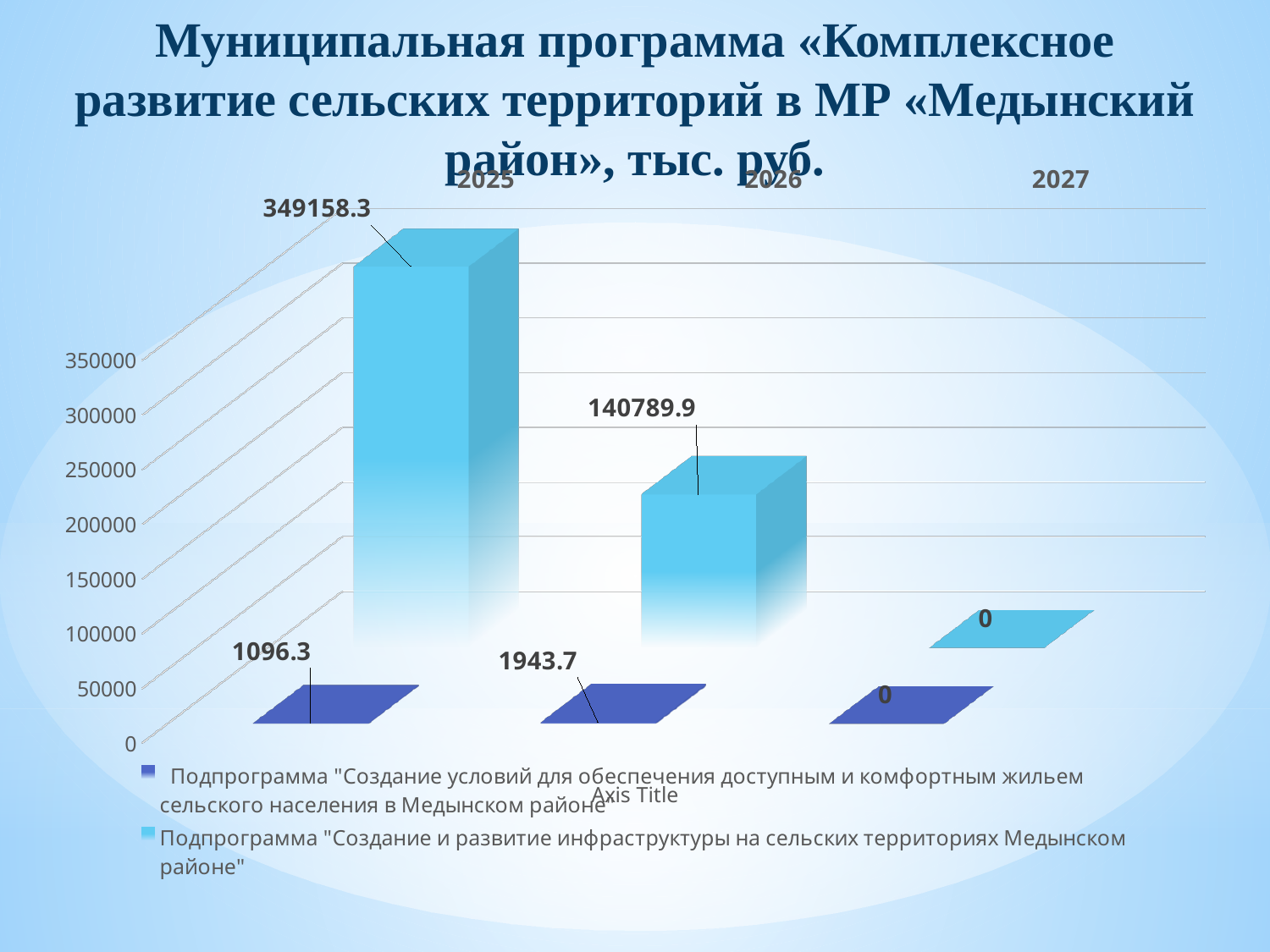
What is the value for 2025 for the subprogram "Создание и развитие инфраструктуры на сельских территориях Медынском районе"? 349158.3 How many series does the legend list? 2 What is the difference between the 2025 and 2026 values for the subprogram "Создание и развитие инфраструктуры на сельских территориях Медынском районе"? 208368.4 Which year has the highest value for the subprogram "Создание и развитие инфраструктуры на сельских территориях Медынском районе"? 2025 Which year has the highest value for the subprogram "Создание условий для обеспечения доступным и комфортным жильем сельского населения в Медынском районе"? 2026 What is the value for 2027 for the subprogram "Создание и развитие инфраструктуры на сельских территориях Медынском районе"? 0 How many years are shown on the x axis of the chart? 3 Which is larger: the 2025 value or the 2026 value for the subprogram "Создание условий для обеспечения доступным и комфортным жильем сельского населения в Медынском районе"? 2026 What kind of chart is shown on the slide? Bar chart What is the value for 2025 for the subprogram "Создание условий для обеспечения доступным и комфортным жильем сельского населения в Медынском районе"? 1096.3 What is the value for 2026 for the subprogram "Создание условий для обеспечения доступным и комфортным жильем сельского населения в Медынском районе"? 1943.7 What is the value for 2026 for the subprogram "Создание и развитие инфраструктуры на сельских территориях Медынском районе"? 140789.9